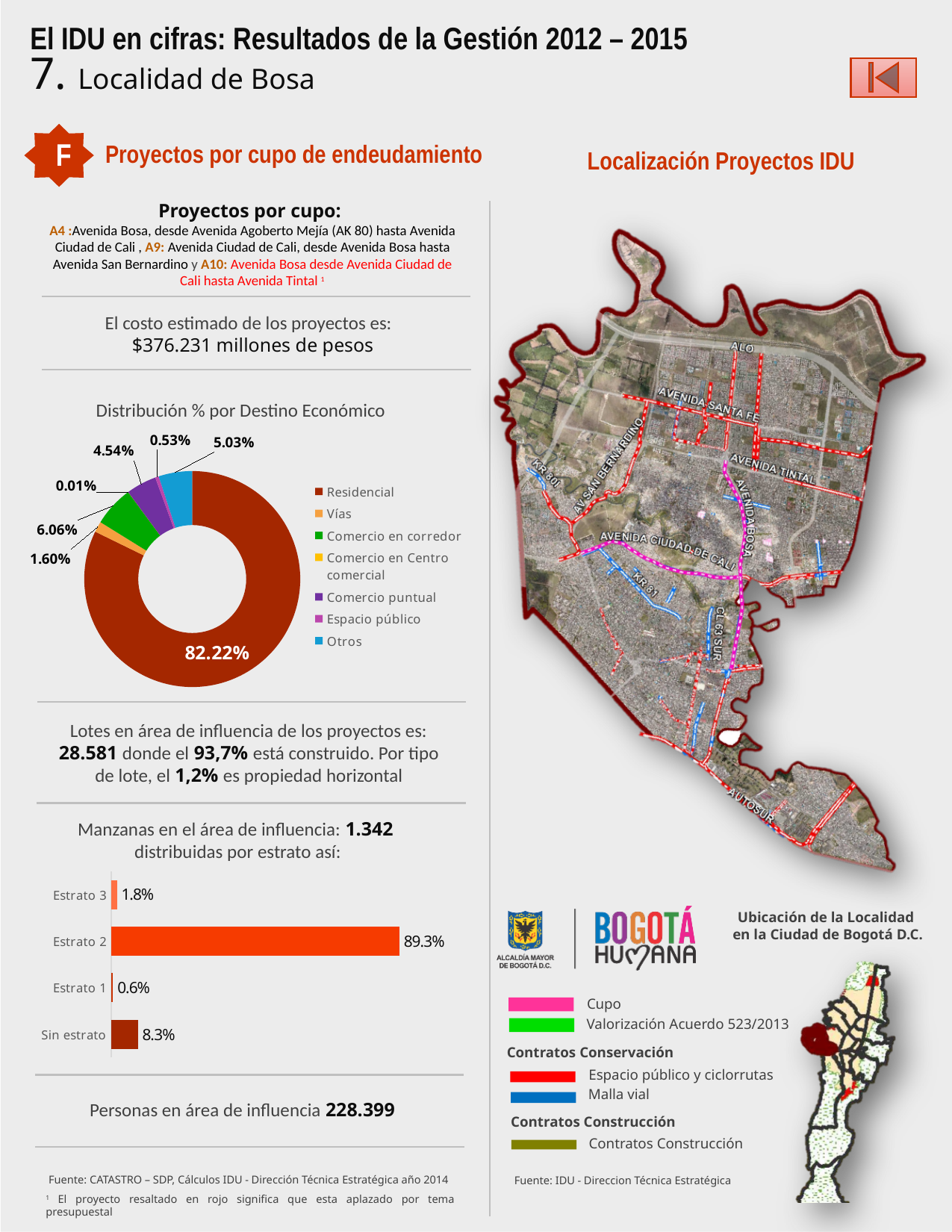
How many categories does the legend of the 'Distribución % por Destino Económico' chart list? 7 In the 'Manzanas en el área de influencia' bar chart, what is the value for Estrato 2? 89.3% What kind of chart is 'Distribución % por Destino Económico'? Donut (pie) chart In the 'Distribución % por Destino Económico' chart, which category has the largest share? Residencial In the 'Distribución % por Destino Económico' chart, what percentage is Residencial? 82.22% In the 'Distribución % por Destino Económico' chart, what percentage is Comercio en corredor? 6.06% In the 'Distribución % por Destino Económico' chart, what percentage is Otros? 5.03% In the 'Manzanas en el área de influencia' bar chart, what is the value for Sin estrato? 8.3% In the 'Distribución % por Destino Económico' chart, which category has the smallest share? Comercio en Centro comercial In the 'Manzanas en el área de influencia' bar chart, what is the difference between Estrato 2 and Sin estrato? 81.0% What kind of chart is the 'Manzanas en el área de influencia' chart? Bar chart In the 'Manzanas en el área de influencia' bar chart, which category has the lowest value? Estrato 1